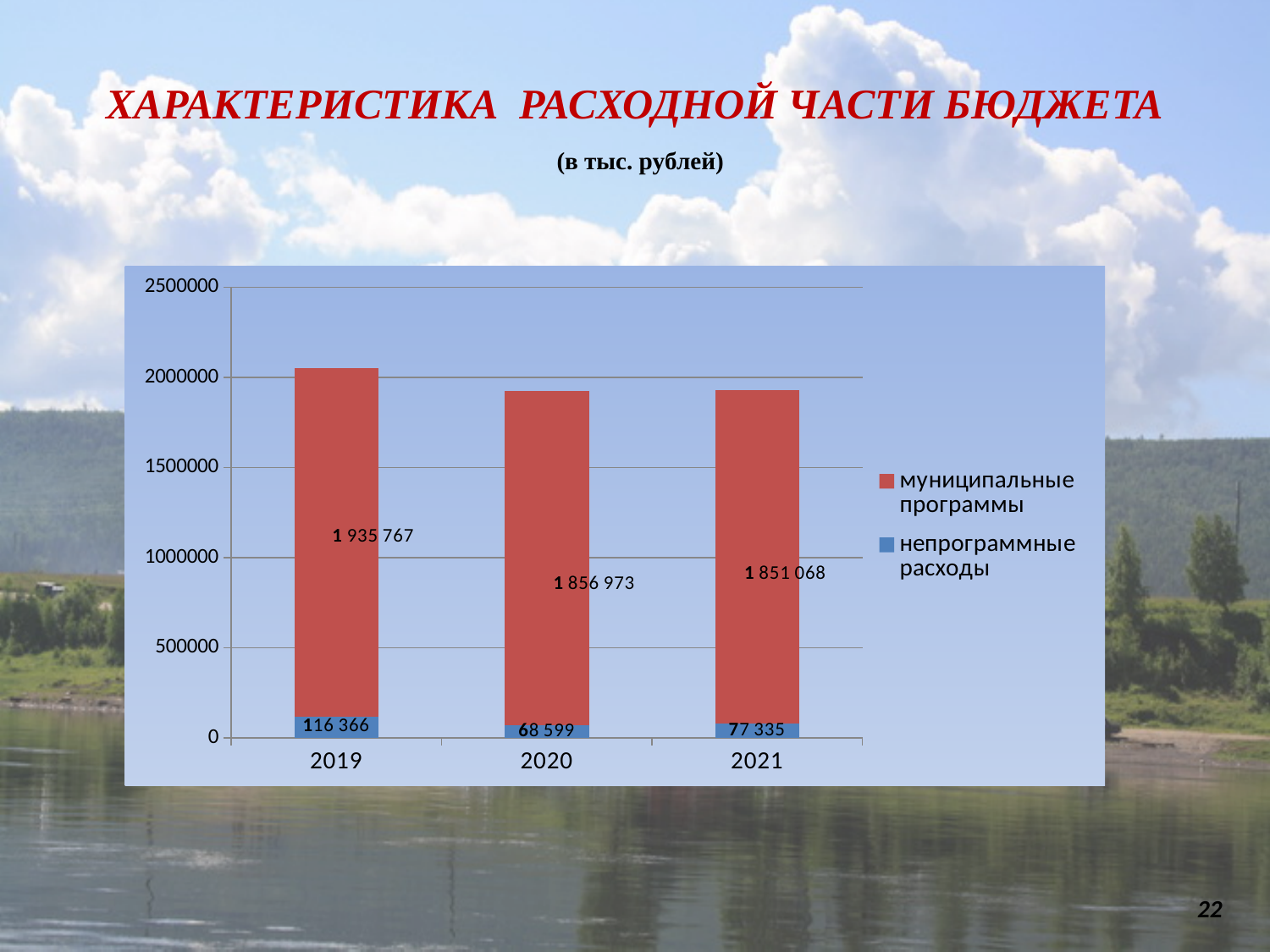
In which year is the value for непрограммные расходы lowest? 2020 What is the difference between the непрограммные расходы values for 2021 and 2020? 8 736 What is the difference between the муниципальные программы values for 2019 and 2020? 78 794 What is the value for непрограммные расходы in 2021? 77 335 In which year is the value for муниципальные программы highest? 2019 What is the value for непрограммные расходы in 2020? 68 599 How many series does the legend list? 2 Which is larger: муниципальные программы in 2020 or in 2021? 2020 What is the value for муниципальные программы in 2019? 1 935 767 Does the value for муниципальные программы rise or fall from 2019 to 2021? fall How many years are shown on the x axis? 3 What is the total of the stacked bar for 2019? 2 052 133